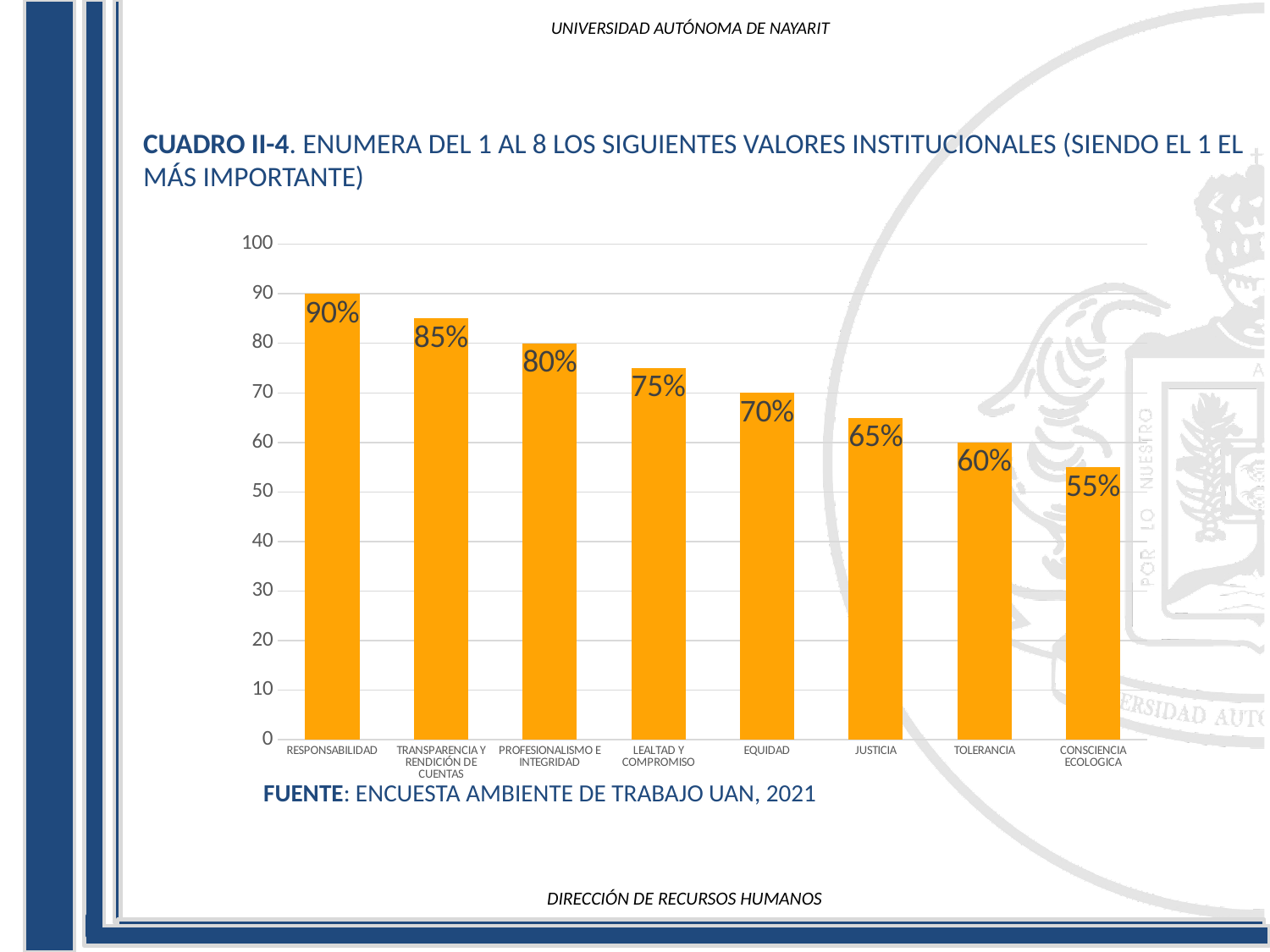
How many categories are shown on the x axis? 8 What is the value for JUSTICIA? 65% What is the difference between the values for RESPONSABILIDAD and TOLERANCIA? 30% Is the value for LEALTAD Y COMPROMISO greater or less than 70? greater Which category has the lowest value? CONSCIENCIA ECOLOGICA Which category has the highest value? RESPONSABILIDAD What is the value for RESPONSABILIDAD? 90% What is the value for CONSCIENCIA ECOLOGICA? 55% Which is larger, the value for EQUIDAD or the value for JUSTICIA? EQUIDAD What source is cited below the chart? ENCUESTA AMBIENTE DE TRABAJO UAN, 2021 Do the values rise or fall from left to right along the x axis? fall What kind of chart is shown on the slide? bar chart